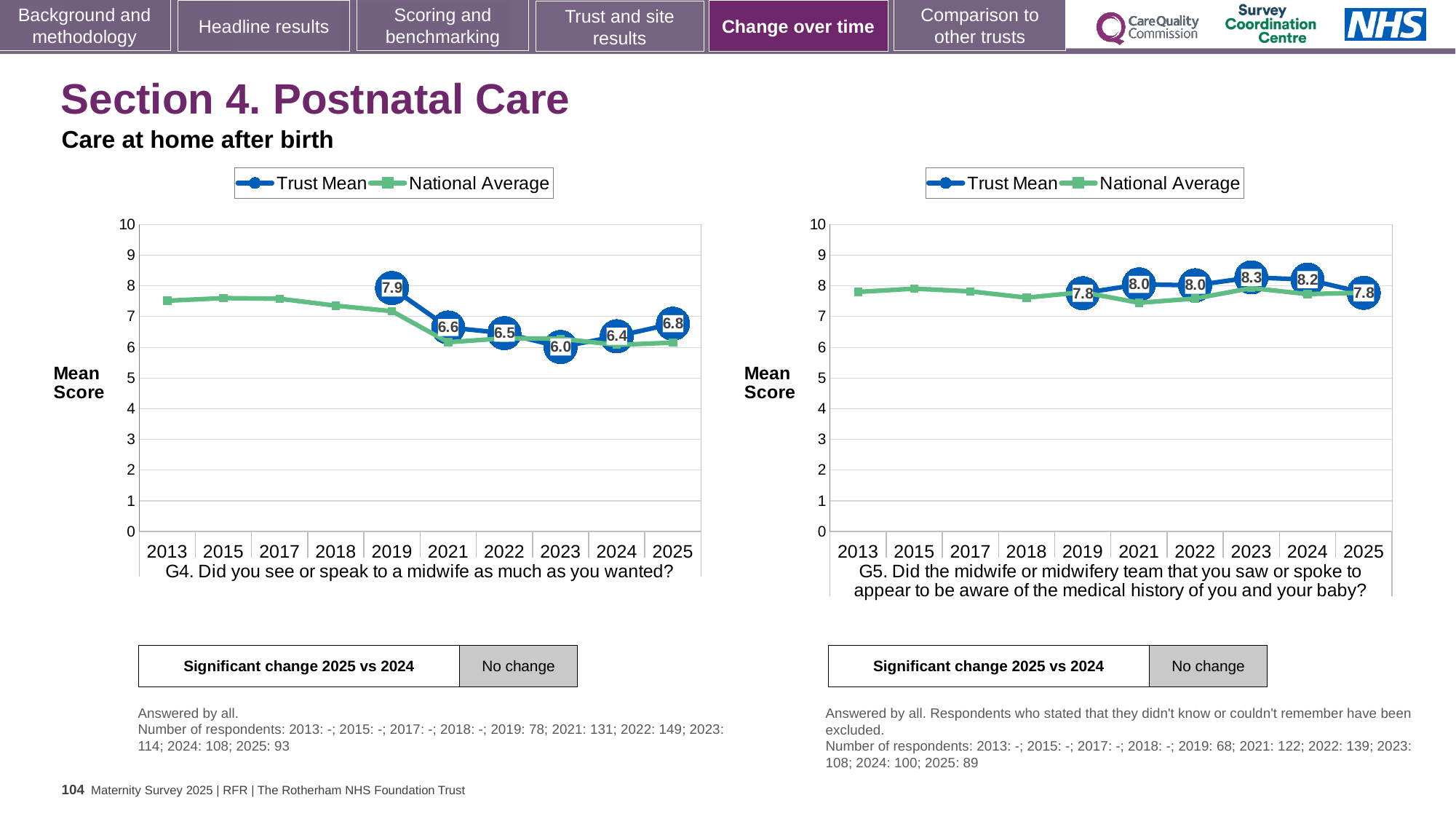
In the G4 chart (left), which year has the lowest Trust Mean? 2023 In the G4 chart (left), is the National Average for 2013 greater or less than 7? greater What kind of chart is the G4 chart (left)? line chart In the G4 chart (left), what is the difference between the Trust Mean in 2019 and in 2021? 1.3 In the G4 chart (left), what is the Trust Mean for 2019? 7.9 In the G4 chart (left), what is the Trust Mean for 2025? 6.8 How many series does the legend of the G5 chart (right) list? 2 In the G5 chart (right), is the Trust Mean for 2024 larger or smaller than the Trust Mean for 2025? larger In the G5 chart (right), what is the Trust Mean for 2023? 8.3 How many years are shown on the x axis of the G4 chart (left)? 10 In the G5 chart (right), what is the difference between the Trust Mean in 2023 and in 2025? 0.5 In the G5 chart (right), which year has the highest Trust Mean? 2023